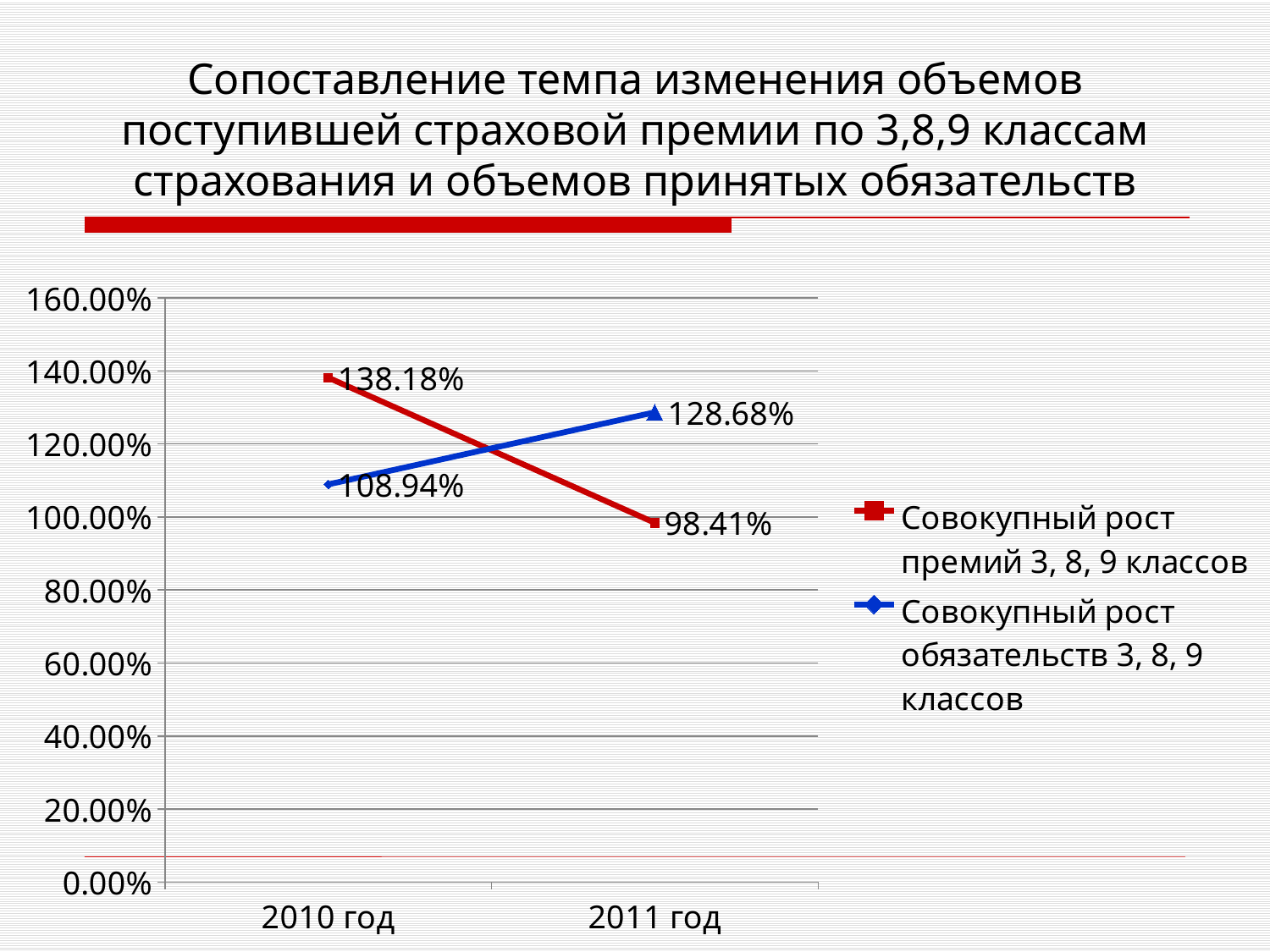
Does the "Совокупный рост обязательств 3, 8, 9 классов" series rise or fall from 2010 год to 2011 год? rise What is the value of "Совокупный рост обязательств 3, 8, 9 классов" for 2010 год? 108.94% Does the "Совокупный рост премий 3, 8, 9 классов" series rise or fall from 2010 год to 2011 год? fall What is the difference between the two series' values in 2011 год? 30.27% What is the difference between the 2010 год and 2011 год values for "Совокупный рост премий 3, 8, 9 классов"? 39.77% Which series has the higher value in 2011 год? Совокупный рост обязательств 3, 8, 9 классов What is the value of "Совокупный рост обязательств 3, 8, 9 классов" for 2011 год? 128.68% What is the value of "Совокупный рост премий 3, 8, 9 классов" for 2010 год? 138.18% What is the value of "Совокупный рост премий 3, 8, 9 классов" for 2011 год? 98.41% Which series has the higher value in 2010 год? Совокупный рост премий 3, 8, 9 классов How many series does the legend list? 2 What kind of chart is shown on the slide? line chart